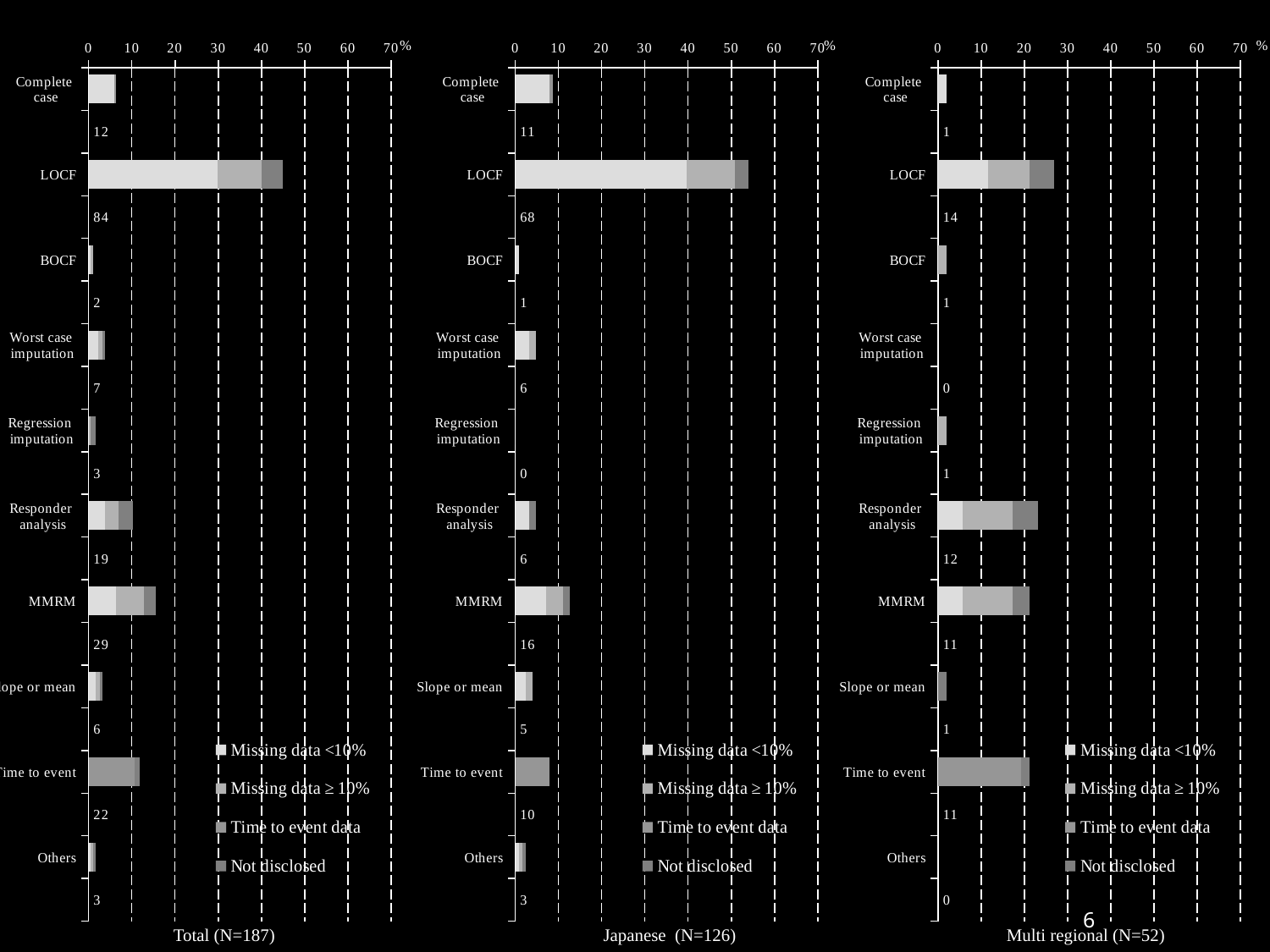
In the Total (N=187) chart, what is the data label for LOCF? 84 How many series does the legend of the Japanese (N=126) chart list? 4 What type of chart is the Multi regional (N=52) chart? Stacked bar chart In the Total (N=187) chart, which has the larger data label, Responder analysis or MMRM? MMRM In the Total (N=187) chart, which category has the highest value? LOCF How many categories are shown in the Total (N=187) chart? 10 In the Japanese (N=126) chart, what is the data label for MMRM? 16 In the Japanese (N=126) chart, which category has the lowest data label? Regression imputation In the Total (N=187) chart, what is the difference between the data labels for LOCF and MMRM? 55 In the Multi regional (N=52) chart, is the LOCF bar greater or less than 20%? greater In the Multi regional (N=52) chart, what is the data label for Responder analysis? 12 In the Japanese (N=126) chart, is the LOCF bar greater or less than 50%? greater